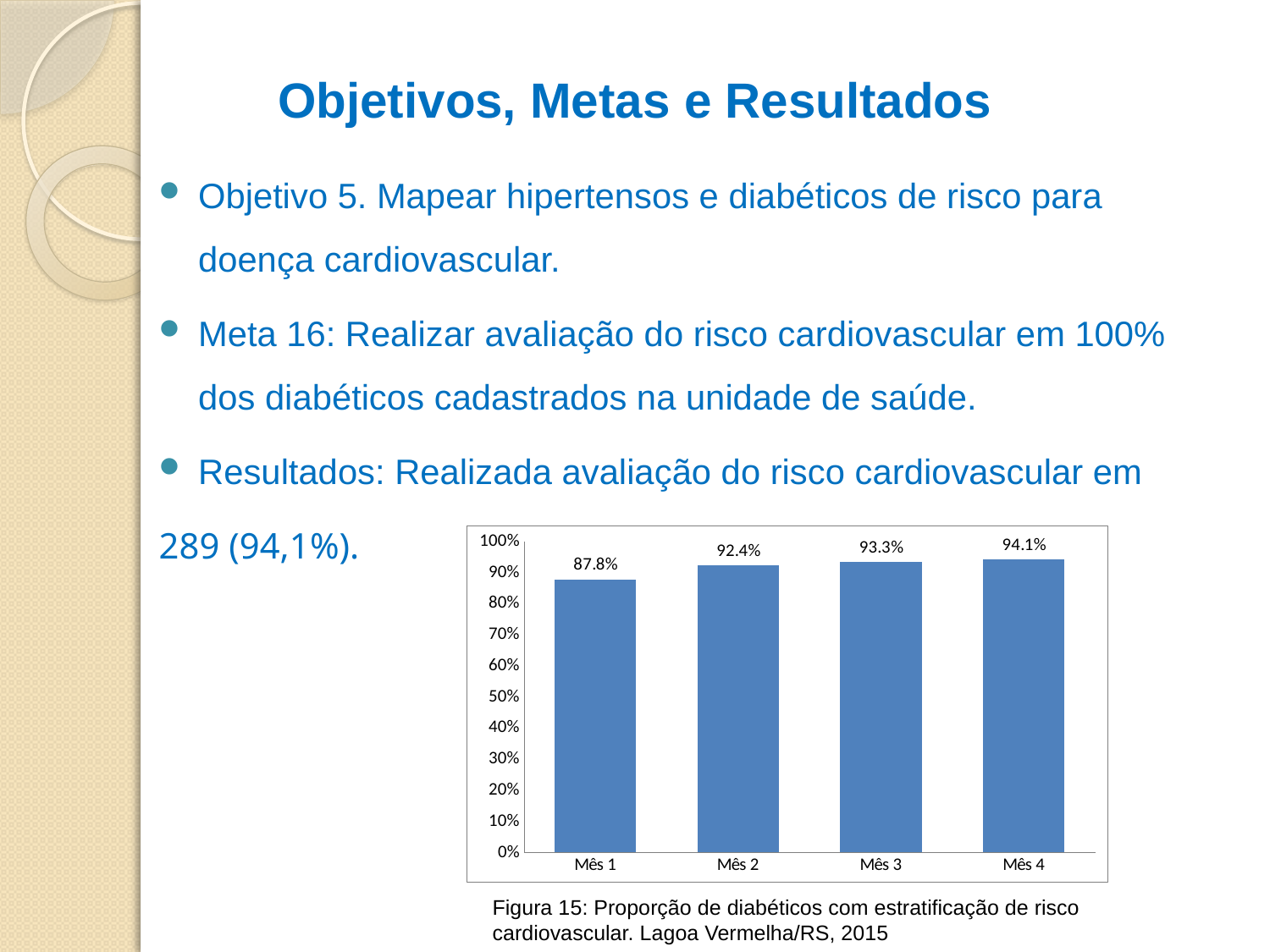
Which is larger, the value for Mês 2 or the value for Mês 1? Mês 2 How many months are shown on the x axis? 4 What is the value for Mês 3? 93.3% What is the difference between the values for Mês 2 and Mês 1? 4.6% Is the value for Mês 1 greater or less than 90%? less Do the values rise or fall from Mês 1 to Mês 4? rise What is the value for Mês 1? 87.8% Which month has the highest value? Mês 4 What is the difference between the values for Mês 4 and Mês 3? 0.8% What kind of chart is shown? bar chart What is the value for Mês 4? 94.1% Which month has the lowest value? Mês 1